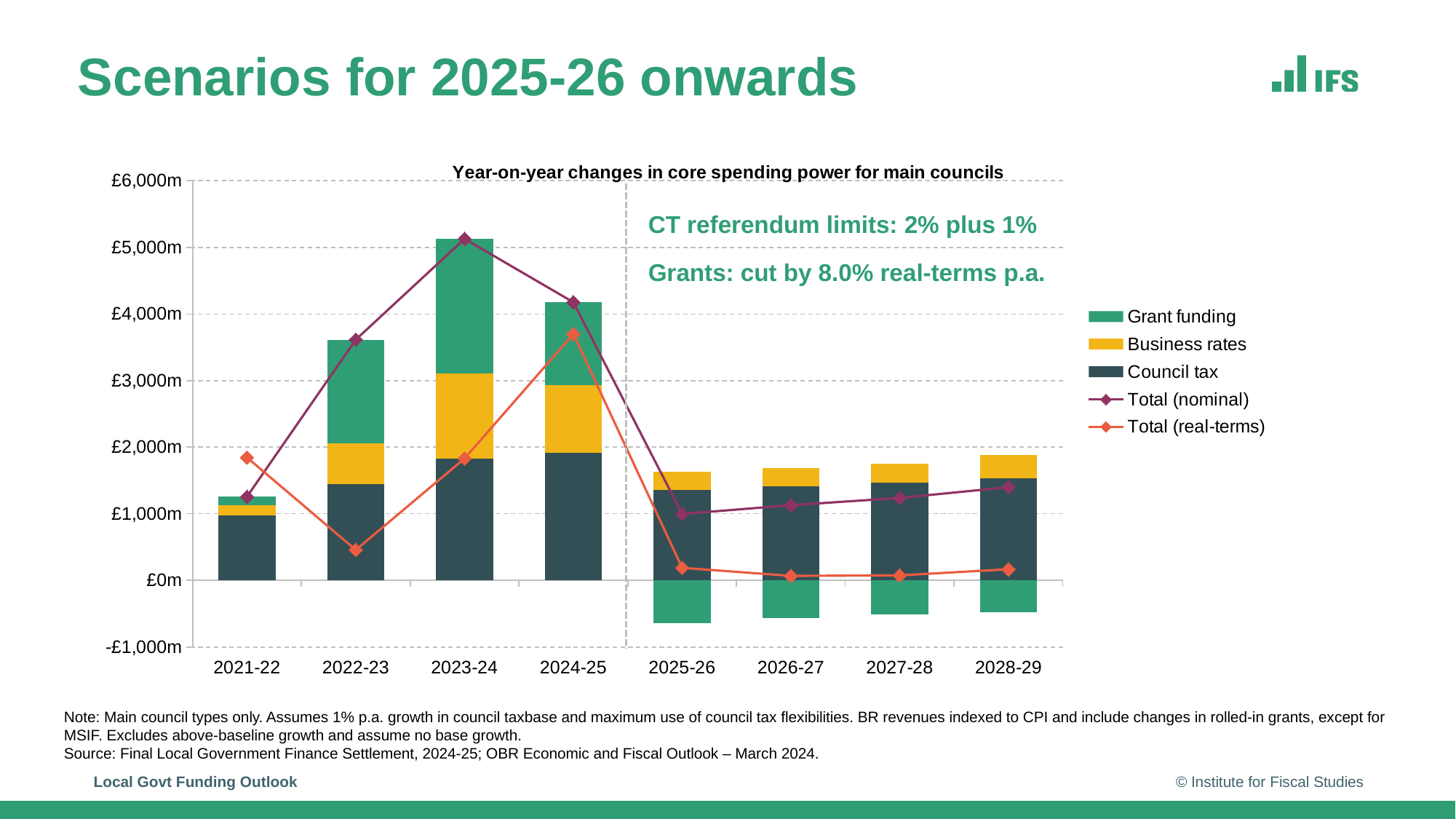
In which year is Total (nominal) highest? 2023-24 How many years are shown on the x axis? 8 Which is larger, Total (nominal) in 2024-25 or Total (nominal) in 2022-23? 2024-25 Is the Total (real-terms) value for 2022-23 greater or less than £1,000m? less Is the Total (nominal) value for 2022-23 greater or less than £3,000m? greater In 2021-22, which is larger, Total (nominal) or Total (real-terms)? Total (real-terms) Does Total (nominal) rise or fall from 2025-26 to 2028-29? Rise In which year is Total (nominal) lowest? 2025-26 What kind of chart is shown on the slide? A stacked bar chart combined with line series Is the Grant funding value for 2025-26 greater or less than £0m? less In which year is Total (real-terms) highest? 2024-25 How many series does the legend list? 5